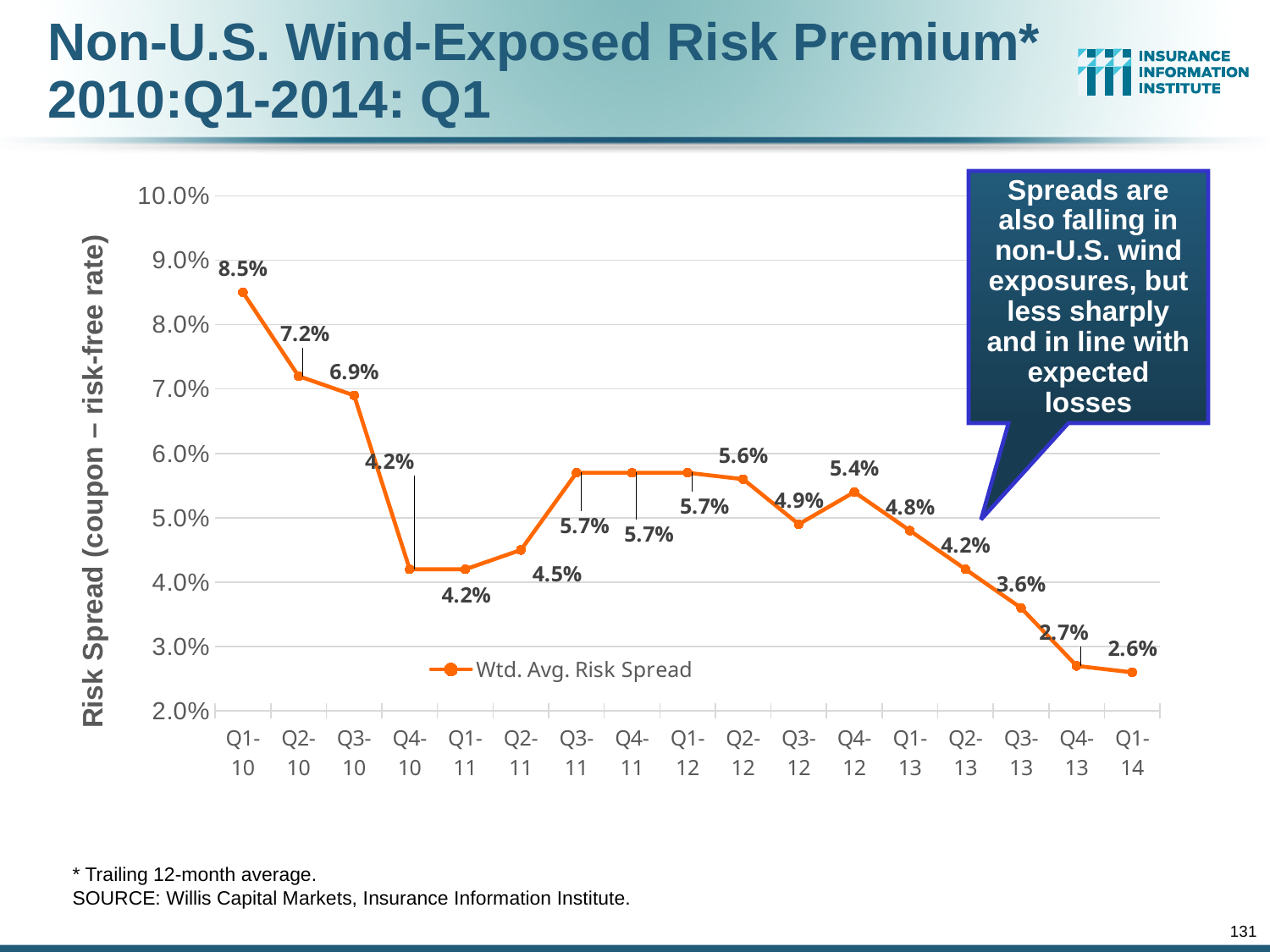
Which is larger, the risk spread in Q2-10 or in Q3-10? Q2-10 What is the weighted average risk spread for Q1-10? 8.5% What is the difference between the risk spread in Q1-10 and Q1-14? 5.9% What is the weighted average risk spread for Q4-12? 5.4% Is the risk spread for Q3-13 greater or less than 4.0%? less What is the label of the y axis? Risk Spread (coupon – risk-free rate) Which quarter has the lowest risk spread? Q1-14 Which quarter has the highest risk spread? Q1-10 What is the weighted average risk spread for Q1-14? 2.6% What kind of chart is shown on the slide? line chart How many series does the legend list? 1 How many quarters are plotted on the chart? 17